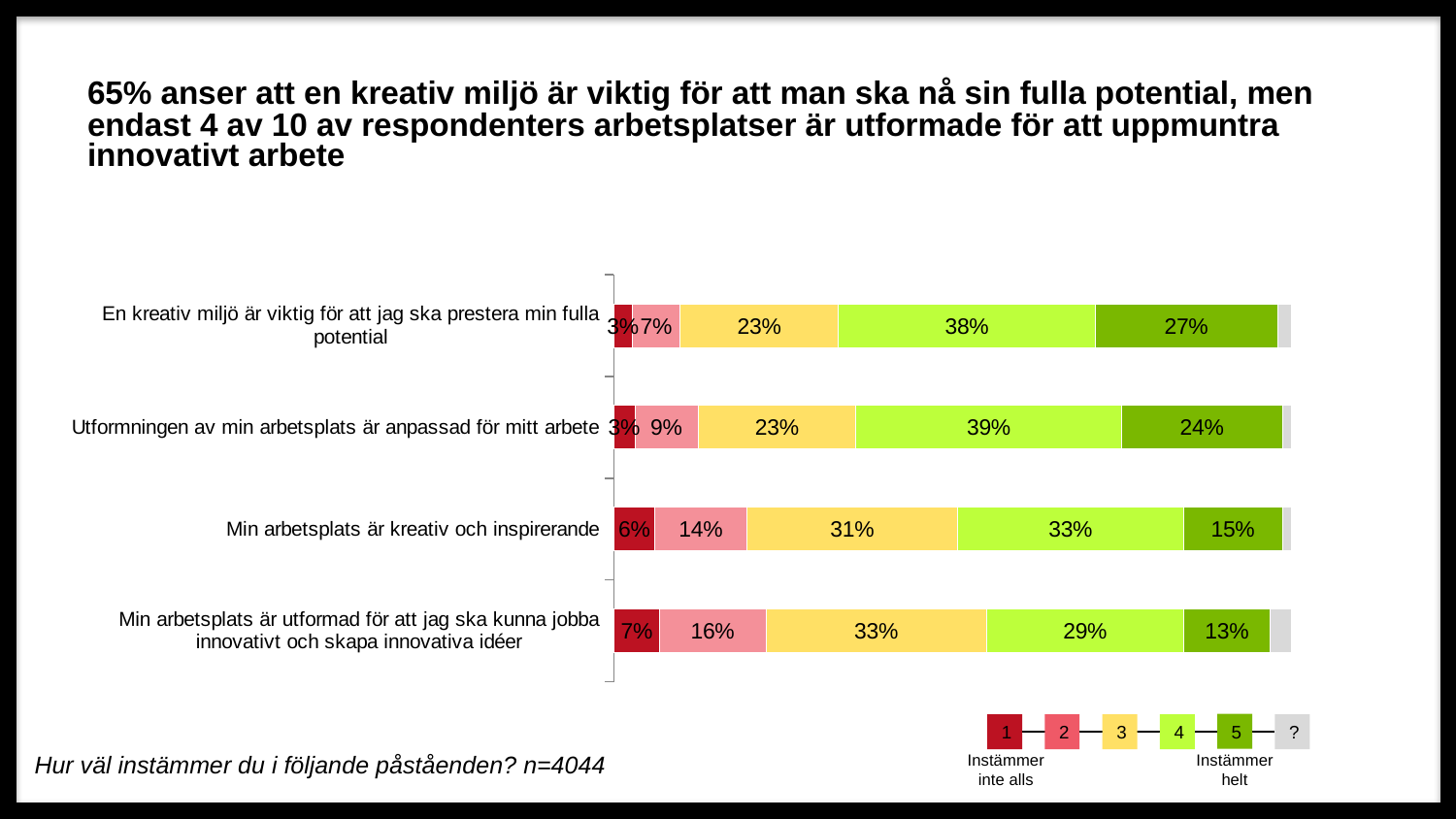
Which statement has a larger 4 segment: "Utformningen av min arbetsplats är anpassad för mitt arbete" or "Min arbetsplats är kreativ och inspirerande"? Utformningen av min arbetsplats är anpassad för mitt arbete What kind of chart is shown on the slide? Stacked bar chart Which statement has the lowest share of respondents answering 5? Min arbetsplats är utformad för att jag ska kunna jobba innovativt och skapa innovativa idéer What percentage of respondents answered 5 (Instämmer helt) for the statement "En kreativ miljö är viktig för att jag ska prestera min fulla potential"? 27% What is the value of the 3 segment for the statement "Min arbetsplats är kreativ och inspirerande"? 31% What label does the legend give to the value 1? Instämmer inte alls How many entries does the legend list? 6 Which statement has the highest share of respondents answering 5? En kreativ miljö är viktig för att jag ska prestera min fulla potential What is the combined share of respondents answering 4 or 5 for the statement "Min arbetsplats är utformad för att jag ska kunna jobba innovativt och skapa innovativa idéer"? 42% How many percentage points higher is the 4 segment for "En kreativ miljö är viktig för att jag ska prestera min fulla potential" than for "Min arbetsplats är utformad för att jag ska kunna jobba innovativt och skapa innovativa idéer"? 9 percentage points What percentage answered 2 for the statement "Min arbetsplats är utformad för att jag ska kunna jobba innovativt och skapa innovativa idéer"? 16% How many statements are shown in the chart? 4